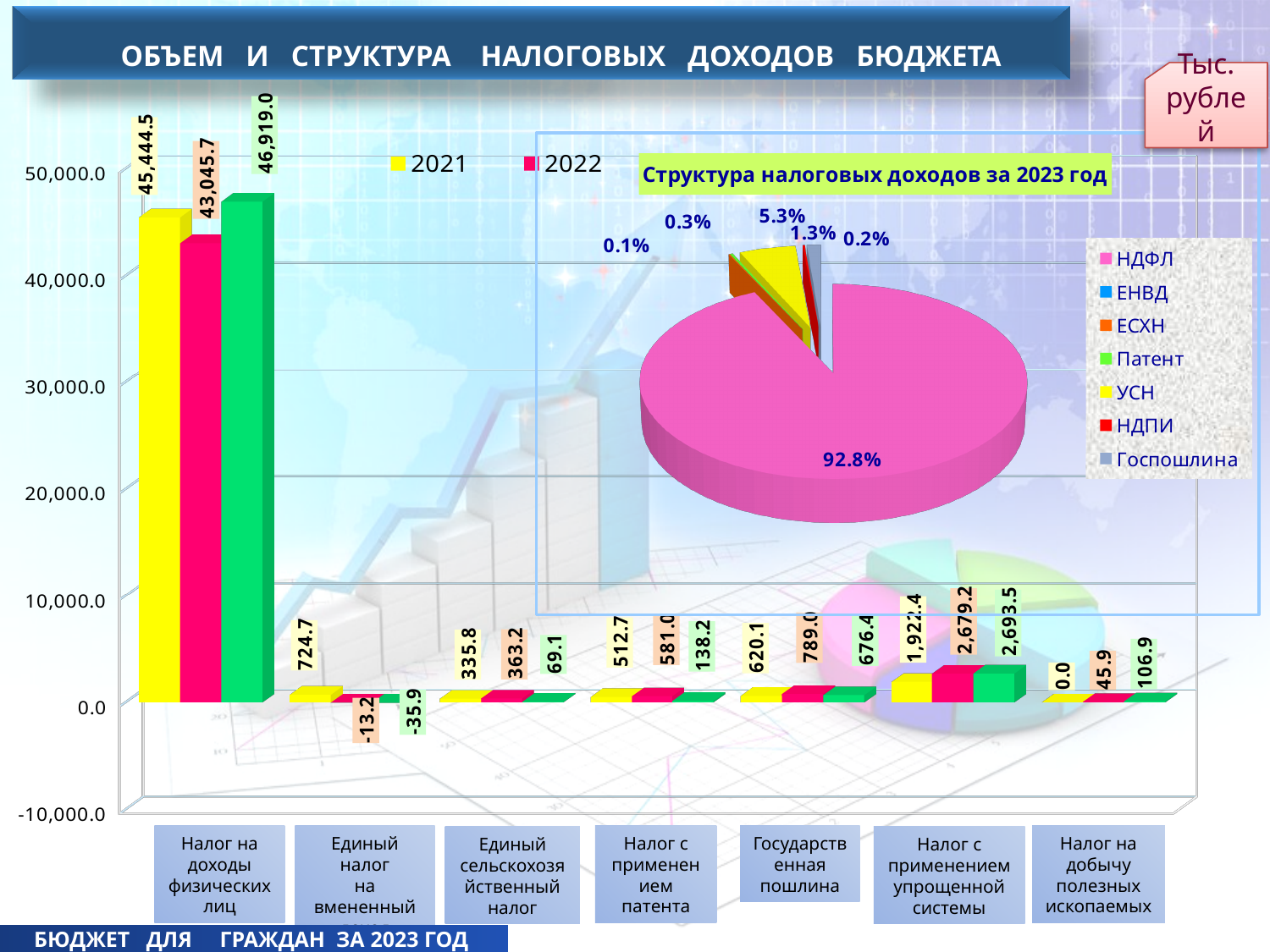
In the bar chart, what is the 2022 value for Налог на доходы физических лиц? 43,045.7 In the bar chart, by how much does the 2021 value for Налог на доходы физических лиц exceed the 2022 value? 2,398.8 In the pie chart Структура налоговых доходов за 2023 год, what share does НДФЛ have? 92.8% In the bar chart, which category has the highest 2021 value? Налог на доходы физических лиц In the bar chart, what is the 2022 value for Единый налог на вмененный? -13.2 In the bar chart, what is the 2021 value for Налог на доходы физических лиц? 45,444.5 In the bar chart, what is the 2021 value for Единый сельскохозяйственный налог? 335.8 In the bar chart, which is larger for Единый сельскохозяйственный налог: the 2021 value or the 2022 value? 2022 What kind of chart is the large chart on the left of the slide (ОБЪЕМ И СТРУКТУРА НАЛОГОВЫХ ДОХОДОВ БЮДЖЕТА)? bar chart How many tax categories are shown along the x axis of the bar chart? 7 How many entries does the legend of the pie chart Структура налоговых доходов за 2023 год list? 7 In the bar chart, what is the 2022 value for Налог с применением упрощенной системы? 2,679.2